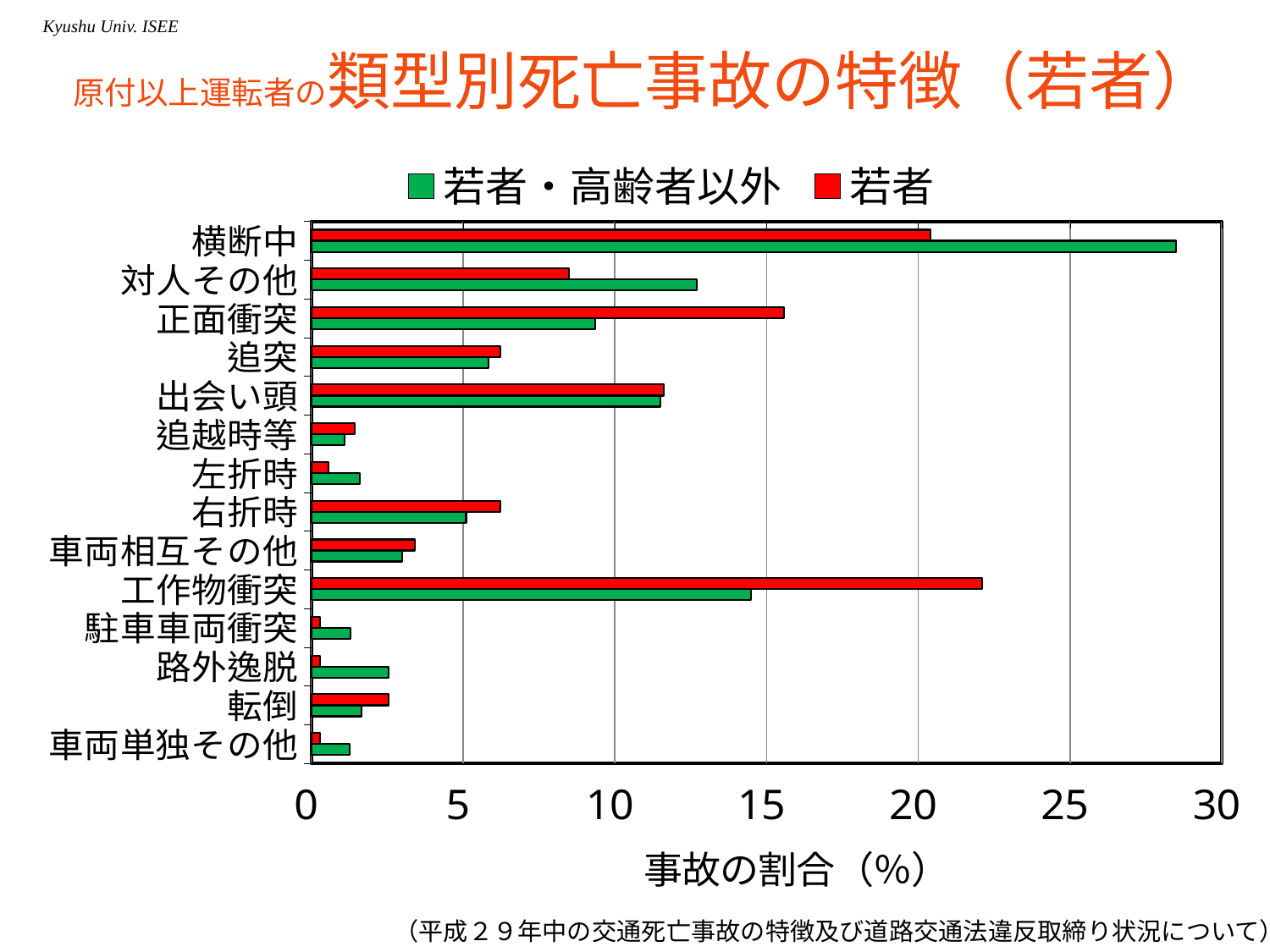
How many series does the legend list? 2 Which category has the highest value for the 若者 series? 工作物衝突 Which colour represents the 若者 series in the legend? red Is the 若者 value for 工作物衝突 greater or less than 20? greater For 正面衝突, which series has the larger value, 若者 or 若者・高齢者以外? 若者 Which category has the highest value for the 若者・高齢者以外 series? 横断中 How many accident-type categories are plotted on the y axis? 14 What is the title of the x axis? 事故の割合（%） Is the 若者・高齢者以外 value for 対人その他 greater or less than 10? greater For 横断中, which series has the larger value, 若者 or 若者・高齢者以外? 若者・高齢者以外 What kind of chart is shown on the slide? bar chart Is the 若者・高齢者以外 value for 横断中 greater or less than 25? greater